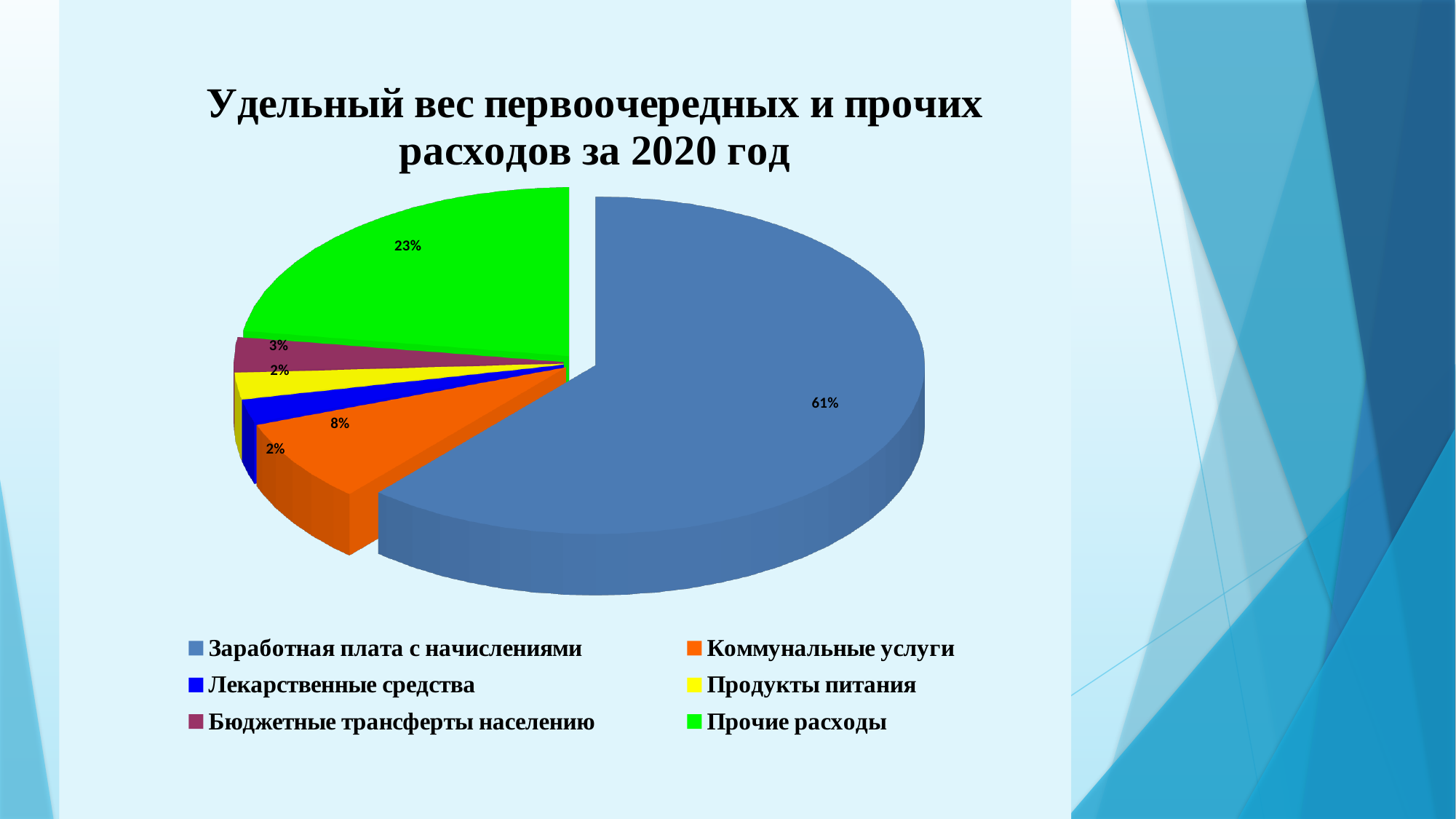
What is the value shown for Прочие расходы? 23% How many categories are shown in the pie chart? 6 What is the value shown for Коммунальные услуги? 8% What is the difference between the shares of Коммунальные услуги and Бюджетные трансферты населению? 5% What colour is the slice for Продукты питания? Yellow What is the value shown for Лекарственные средства? 2% Which is larger, the share of Прочие расходы or the share of Коммунальные услуги? Прочие расходы What is the value shown for Бюджетные трансферты населению? 3% Which category has the largest slice of the pie? Заработная плата с начислениями What share of the pie does Заработная плата с начислениями take? 61% What is the difference between the shares of Заработная плата с начислениями and Прочие расходы? 38% What type of chart is shown on the slide? Pie chart